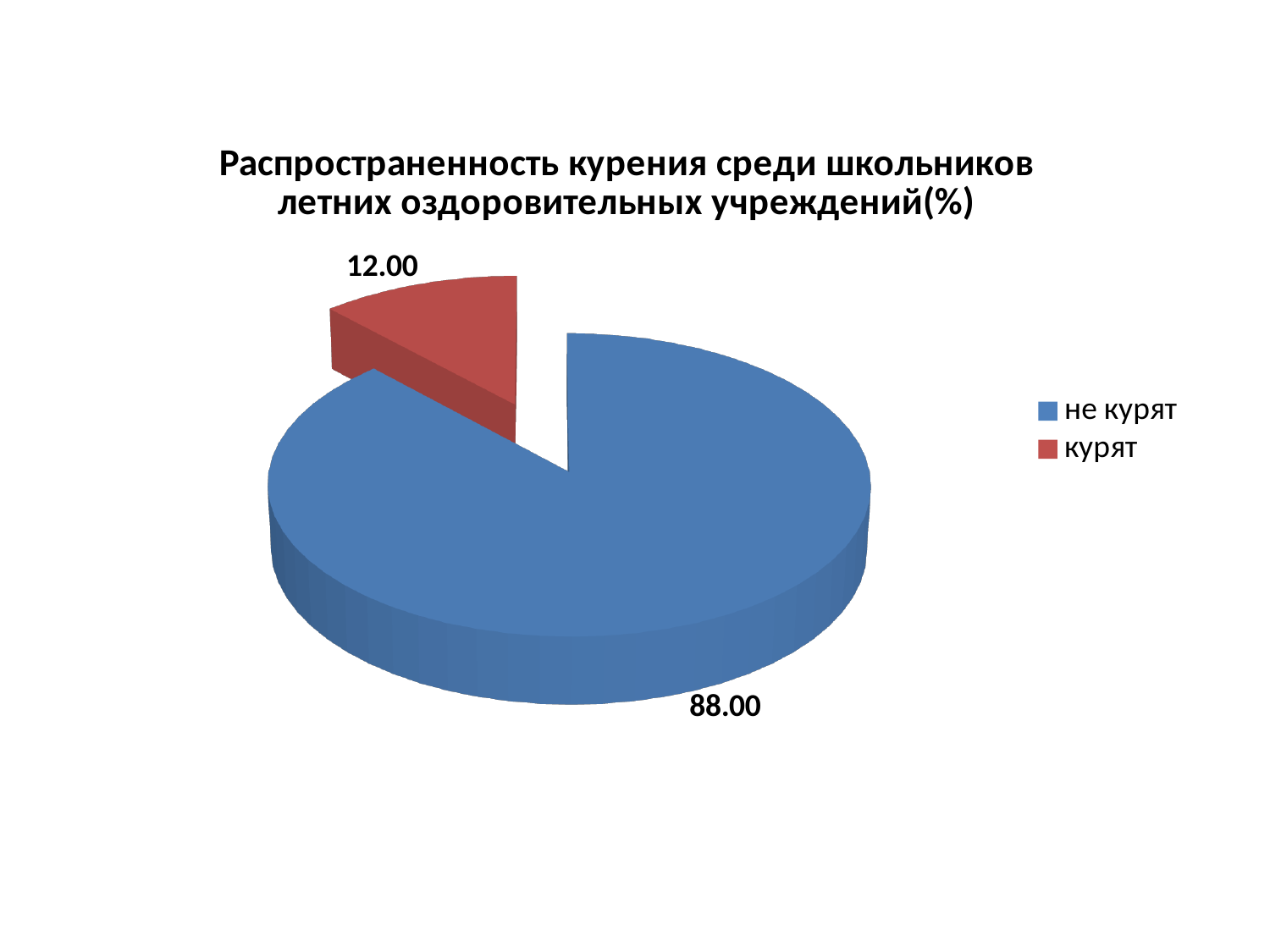
Which is larger, the value for "курят" or the value for "не курят"? не курят What colour is the "курят" slice? red What is the total of the two slice values? 100.00 What kind of chart is shown on the slide? pie chart What share of the pie does the "курят" slice represent? 12.00% Which category has the smallest slice of the pie? курят What value is shown for the "не курят" slice? 88.00 What is the title of the chart? Распространенность курения среди школьников летних оздоровительных учреждений(%) Which category has the largest slice of the pie? не курят How many slices does the pie chart have? 2 What value is shown for the "курят" slice? 12.00 What is the difference between the values for "не курят" and "курят"? 76.00